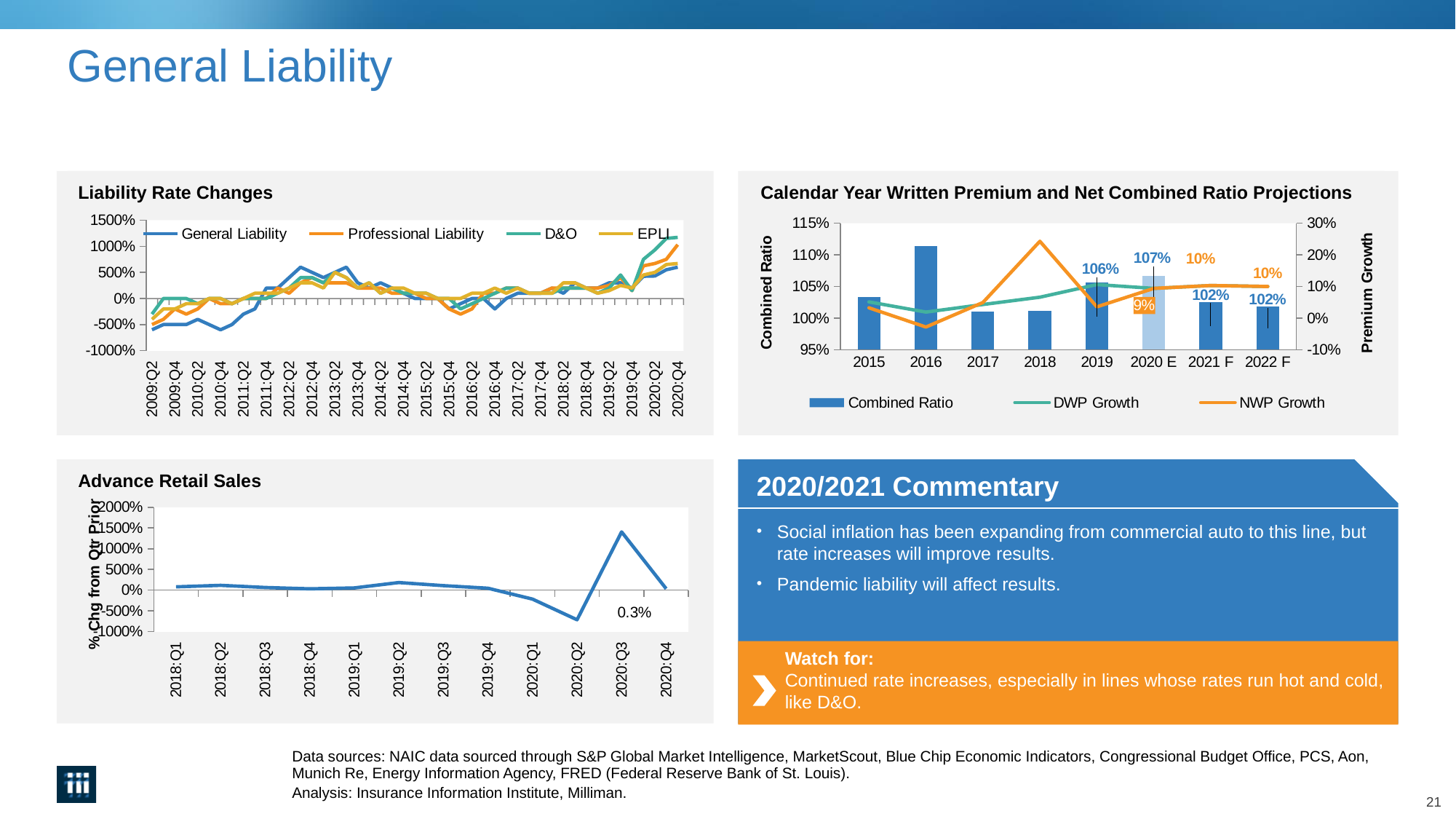
In the Calendar Year Written Premium and Net Combined Ratio Projections chart, what is the combined ratio for 2020 E? 107% How many series does the legend of the Liability Rate Changes chart list? 4 How many series does the legend of the Calendar Year Written Premium and Net Combined Ratio Projections chart list? 3 How many years are shown on the x axis of the Calendar Year Written Premium and Net Combined Ratio Projections chart? 8 In the Calendar Year Written Premium and Net Combined Ratio Projections chart, which year has the highest combined ratio bar? 2016 In the Advance Retail Sales chart, what is the value for 2020:Q4? 0.3% In the Advance Retail Sales chart, which quarter has the highest value? 2020:Q3 In the Calendar Year Written Premium and Net Combined Ratio Projections chart, what is the combined ratio for 2022 F? 102% In the Calendar Year Written Premium and Net Combined Ratio Projections chart, is the NWP Growth value for 2018 greater or less than 20%? greater What kind of chart is the Advance Retail Sales chart? Line chart In the Calendar Year Written Premium and Net Combined Ratio Projections chart, what is the combined ratio for 2019? 106% In the Calendar Year Written Premium and Net Combined Ratio Projections chart, what is the difference between the combined ratio for 2020 E and for 2021 F? 5 percentage points